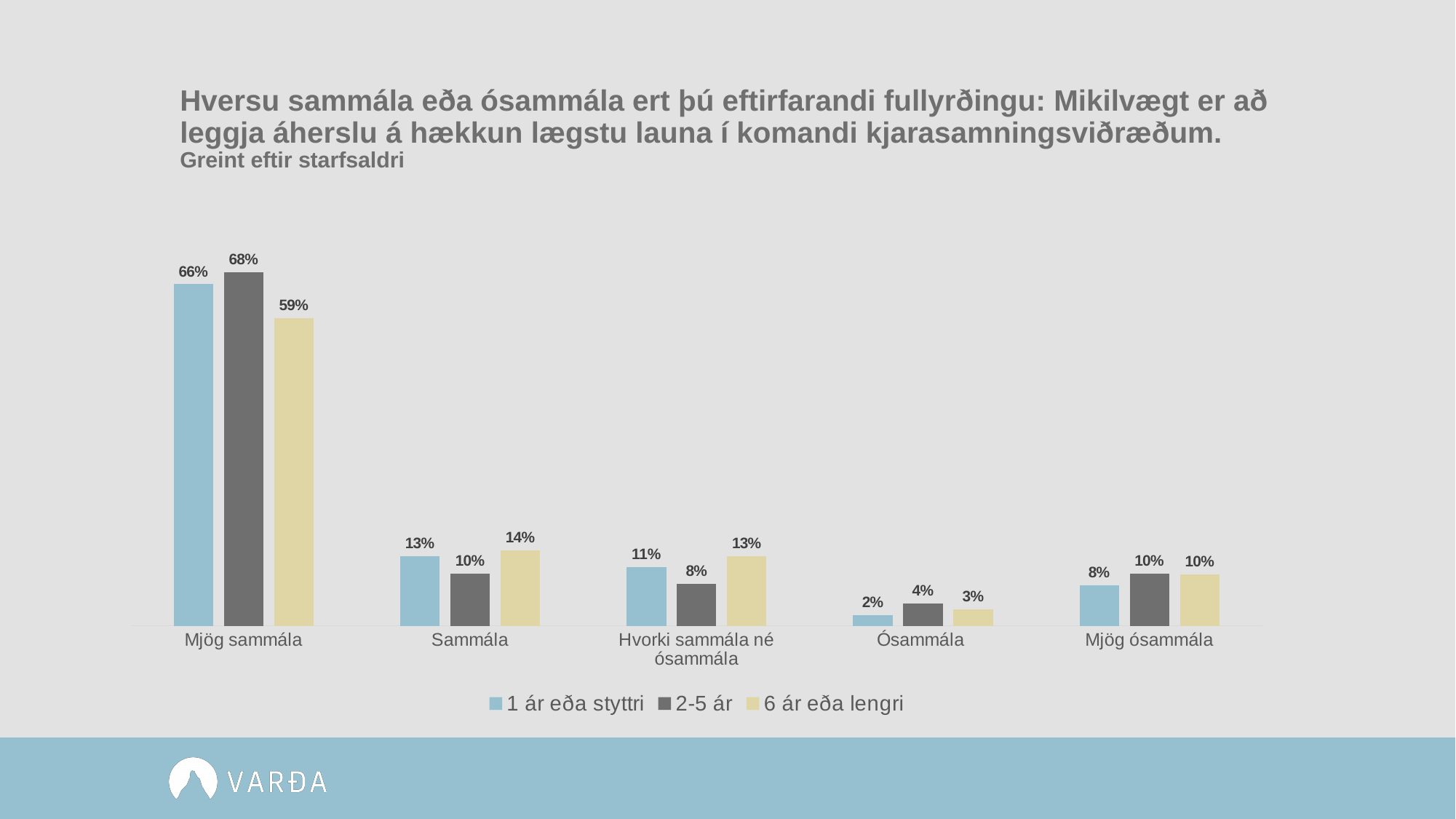
What is the value for "1 ár eða styttri" in the "Ósammála" category? 2% What is the value for "6 ár eða lengri" in the "Sammála" category? 14% What kind of chart is shown on the slide? Bar chart How many series does the legend list? 3 In the "Hvorki sammála né ósammála" category, which is larger: "1 ár eða styttri" or "2-5 ár"? 1 ár eða styttri Which series is shown in yellow? 6 ár eða lengri What is the value for "2-5 ár" in the "Mjög sammála" category? 68% How many categories are shown on the x axis? 5 Which category has the highest value for the "1 ár eða styttri" series? Mjög sammála What is the subtitle shown below the chart title? Greint eftir starfsaldri Which category has the lowest value for the "6 ár eða lengri" series? Ósammála What is the difference between the "2-5 ár" and "6 ár eða lengri" values in the "Mjög sammála" category? 9%